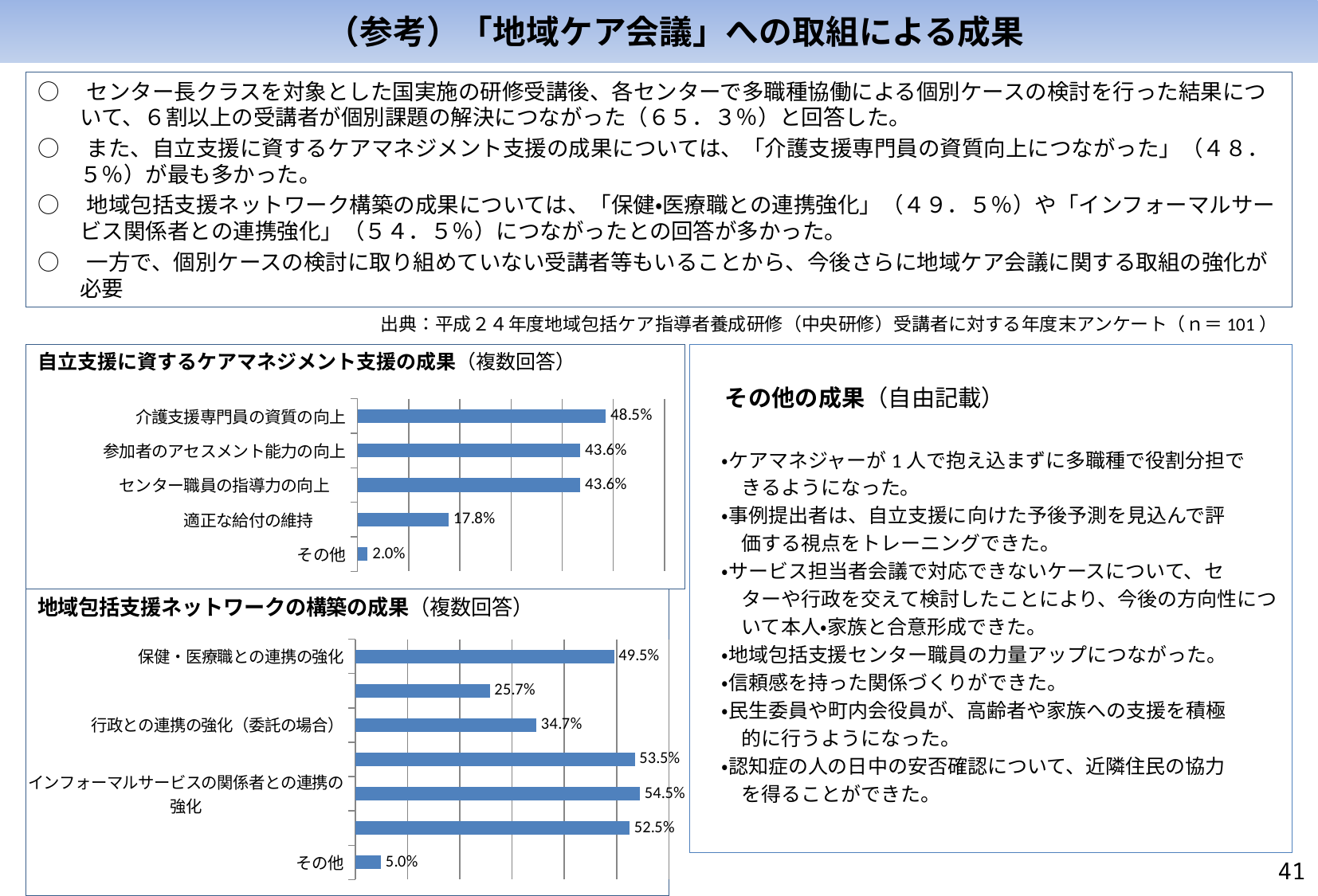
In the chart titled 自立支援に資するケアマネジメント支援の成果, which category has the lowest value? その他 In the chart titled 地域包括支援ネットワークの構築の成果, what is the value for 保健・医療職との連携の強化? 49.5% In the chart titled 自立支援に資するケアマネジメント支援の成果, which category has the highest value? 介護支援専門員の資質の向上 How many categories are shown in the chart titled 自立支援に資するケアマネジメント支援の成果? 5 In the chart titled 地域包括支援ネットワークの構築の成果, what is the difference between インフォーマルサービスの関係者との連携の強化 and 保健・医療職との連携の強化? 5.0% In the chart titled 自立支援に資するケアマネジメント支援の成果, what is the difference between 介護支援専門員の資質の向上 and 適正な給付の維持? 30.7% In the chart titled 地域包括支援ネットワークの構築の成果, what is the value for その他? 5.0% In the chart titled 自立支援に資するケアマネジメント支援の成果, what is the value for 介護支援専門員の資質の向上? 48.5% In the chart titled 地域包括支援ネットワークの構築の成果, what is the value for 行政との連携の強化（委託の場合）? 34.7% What type of chart is the chart titled 自立支援に資するケアマネジメント支援の成果? Bar chart In the chart titled 地域包括支援ネットワークの構築の成果, which is larger: 保健・医療職との連携の強化 or 行政との連携の強化（委託の場合）? 保健・医療職との連携の強化 In the chart titled 自立支援に資するケアマネジメント支援の成果, what is the value for 適正な給付の維持? 17.8%